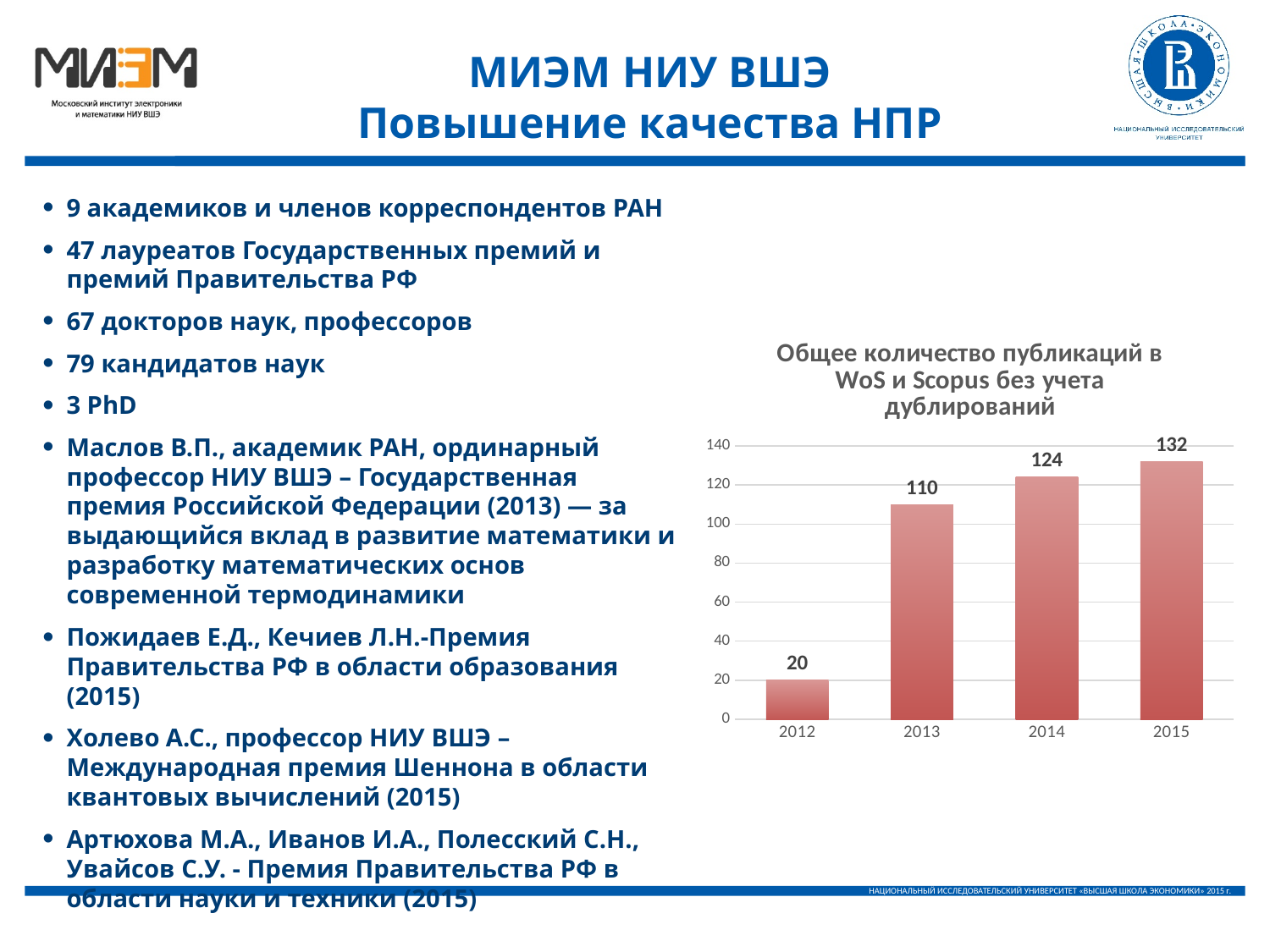
What is the value for 2015? 132 What kind of chart is shown? bar chart What is the difference between the values for 2015 and 2014? 8 What is the difference between the values for 2013 and 2012? 90 What is the value for 2014? 124 How many years are shown on the x axis? 4 What is the value for 2013? 110 Which year has the lowest value? 2012 Do the values rise or fall from 2012 to 2015? rise Which is larger, the value for 2013 or the value for 2014? 2014 What is the value for 2012? 20 Which year has the highest value? 2015